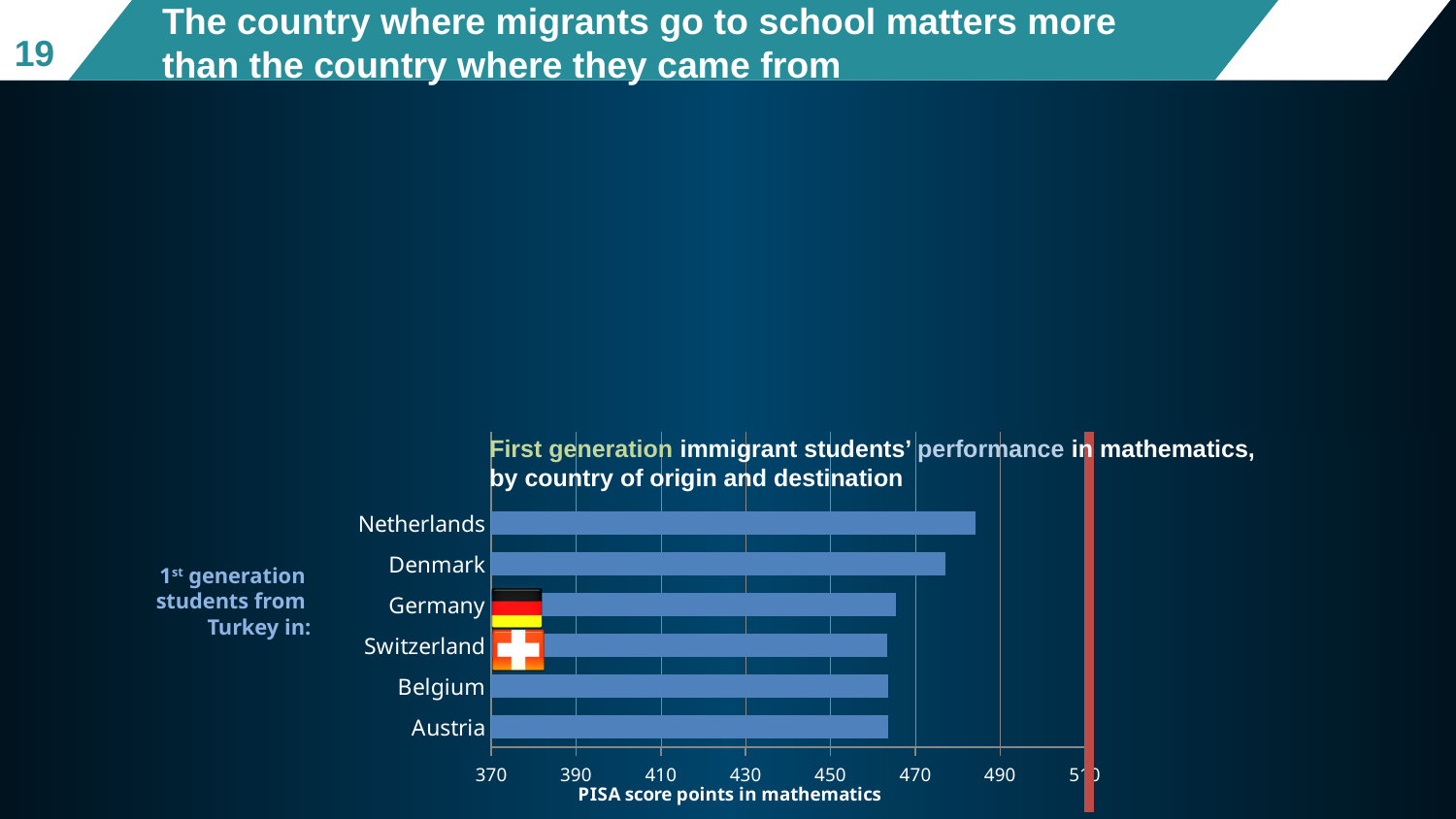
Is the value for the Netherlands greater or less than 470? greater What is the label of the horizontal axis of the chart? PISA score points in mathematics Is the value for Switzerland greater or less than 450? greater How many destination countries are plotted in the chart? 6 Which has a higher value, Denmark or Austria? Denmark Is the value for Belgium greater or less than 490? less Which has a higher value, the Netherlands or Germany? Netherlands What kind of chart is shown on the slide? bar chart Which country has the highest PISA mathematics score for first-generation students from Turkey? Netherlands